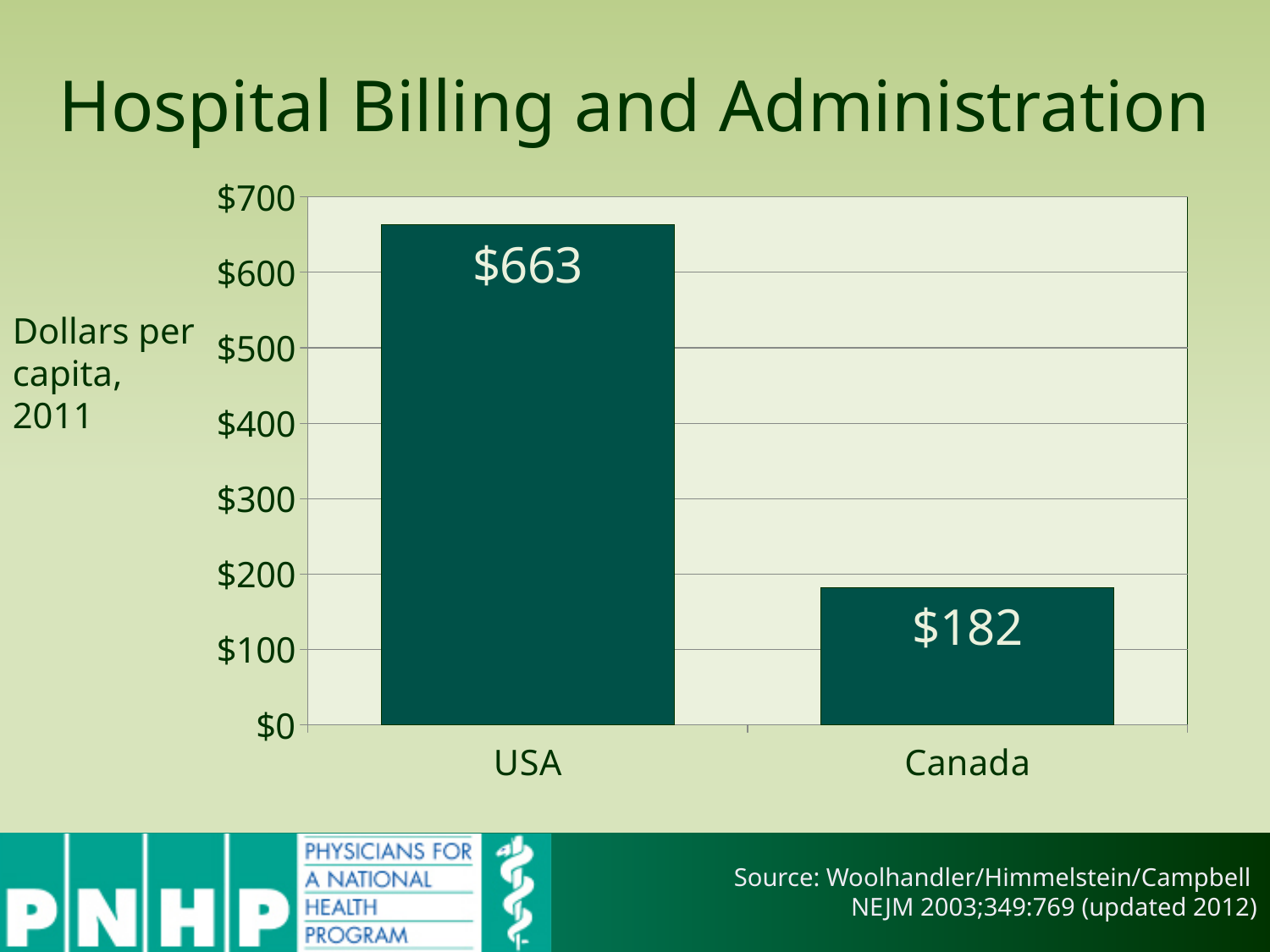
Which category has the highest value? USA What is the value for Canada? $182 What kind of chart is shown on the slide? bar chart What is the difference between the USA and Canada values? $481 Is the value for Canada greater or less than $200? less Is the value for USA greater or less than $600? greater What is the value for USA? $663 What is the title of the chart? Hospital Billing and Administration How many categories are shown on the chart? 2 Which is larger, the value for USA or the value for Canada? USA Which category has the lowest value? Canada What unit does the y-axis label describe? Dollars per capita, 2011